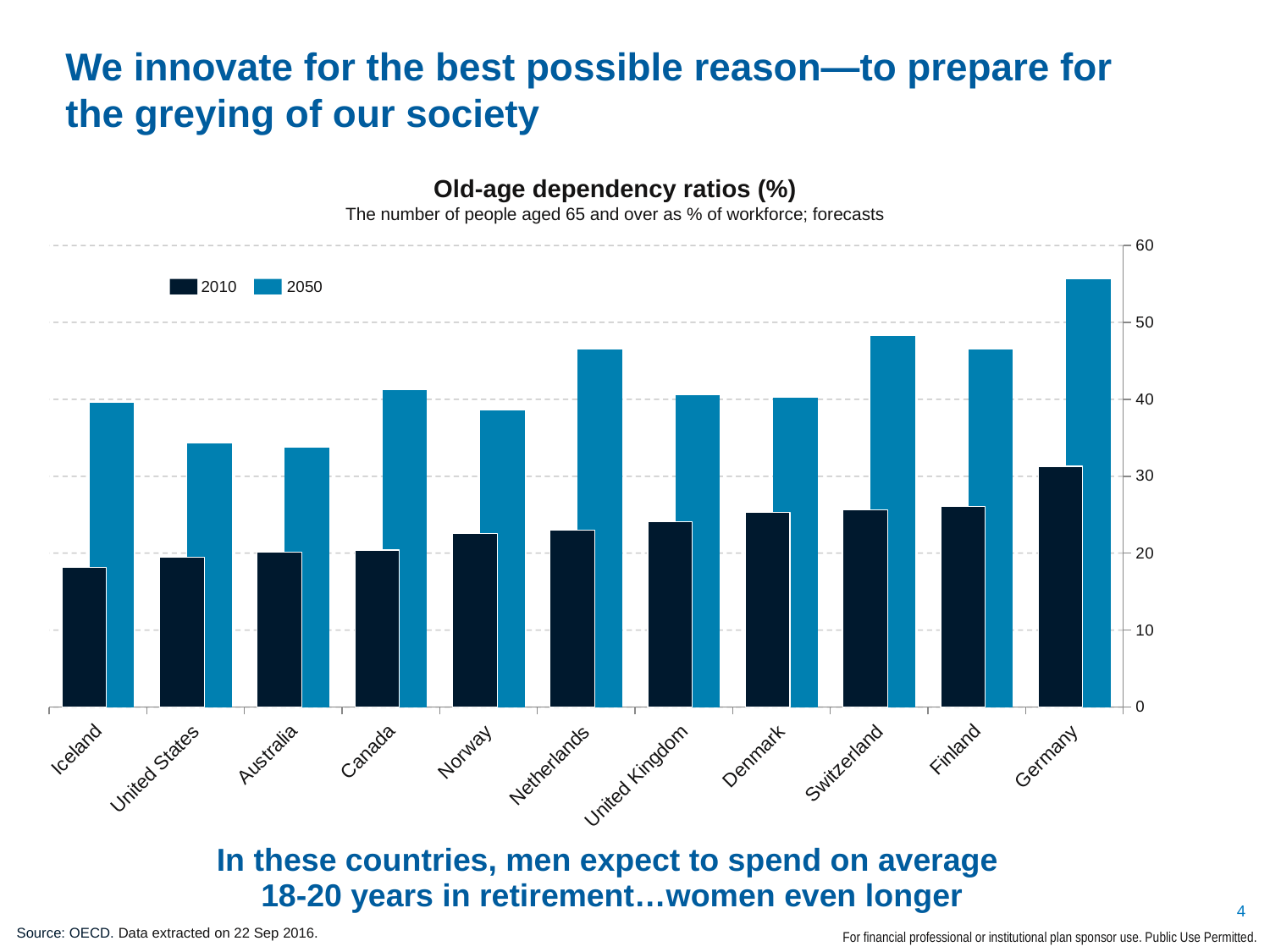
Is the 2050 value for Switzerland greater or less than 50? less Which country has the highest 2010 old-age dependency ratio? Germany Which is larger, the 2050 value for Switzerland or the 2050 value for Canada? Switzerland Which country has the lowest 2010 old-age dependency ratio? Iceland Is the 2050 value for Germany greater or less than 50? greater What is the title of the chart? Old-age dependency ratios (%) What type of chart is shown on the slide? Bar chart Do the 2010 values generally rise or fall moving from Iceland to Germany along the x axis? rise Is the 2010 value for Iceland greater or less than 20? less How many countries are shown on the x axis? 11 Which country has the highest 2050 old-age dependency ratio? Germany How many series does the legend list? 2